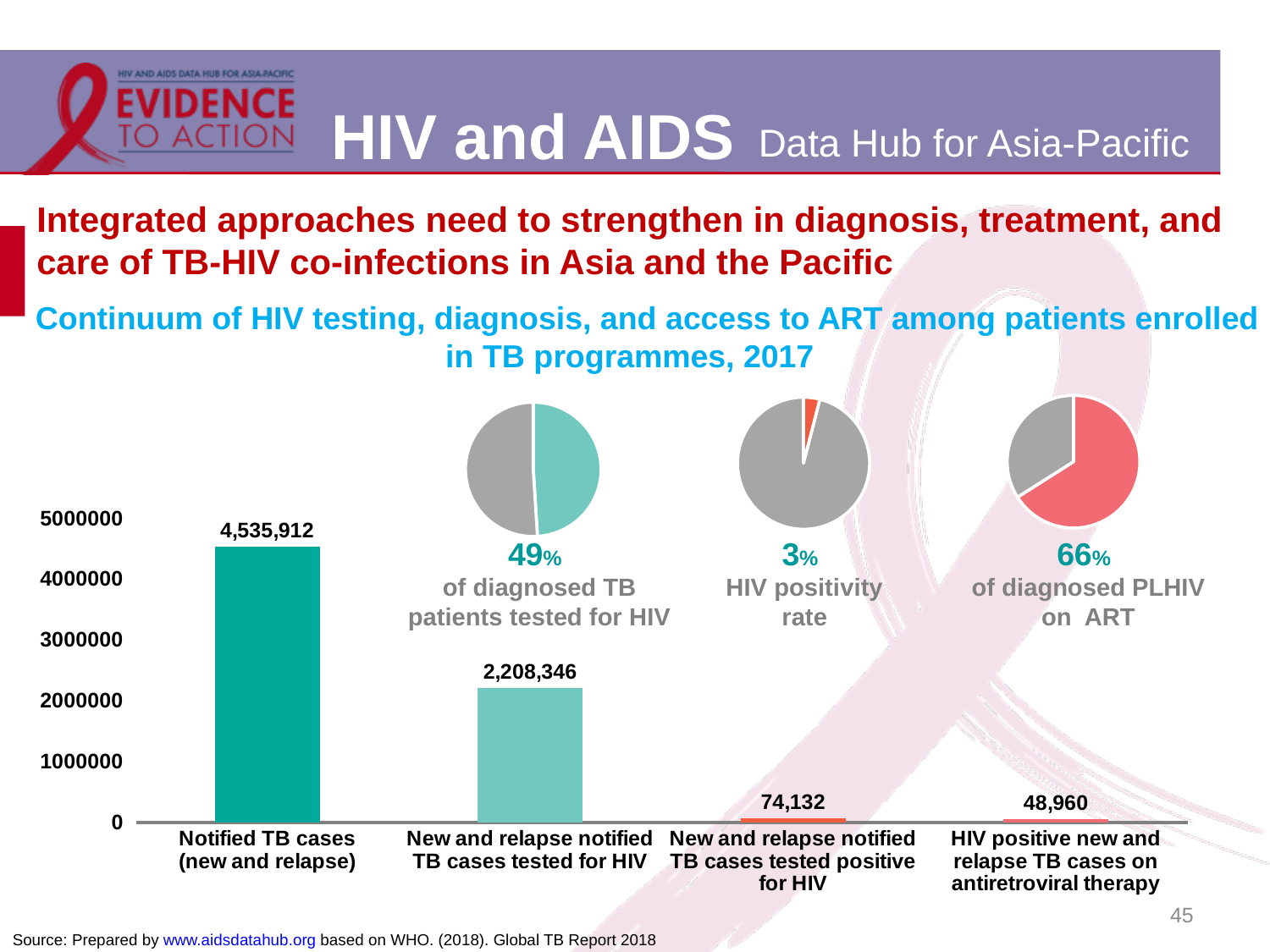
In the bar chart, what is the value for New and relapse notified TB cases tested for HIV? 2,208,346 In the bar chart, which category has the lowest value? HIV positive new and relapse TB cases on antiretroviral therapy How many categories are shown in the bar chart? 4 In the bar chart, what is the value for HIV positive new and relapse TB cases on antiretroviral therapy? 48,960 According to the pie chart labelled 'HIV positivity rate', what is the HIV positivity rate? 3% In the bar chart, what is the value for Notified TB cases (new and relapse)? 4,535,912 What kind of chart shows the TB case numbers along the bottom of the slide? Bar chart In the bar chart, what is the difference between New and relapse notified TB cases tested positive for HIV and HIV positive new and relapse TB cases on antiretroviral therapy? 25,172 In the bar chart, what is the difference between Notified TB cases (new and relapse) and New and relapse notified TB cases tested for HIV? 2,327,566 Do the values in the bar chart rise or fall from left to right along the x axis? Fall In the bar chart, which category has the highest value? Notified TB cases (new and relapse) In the bar chart, what is the value for New and relapse notified TB cases tested positive for HIV? 74,132